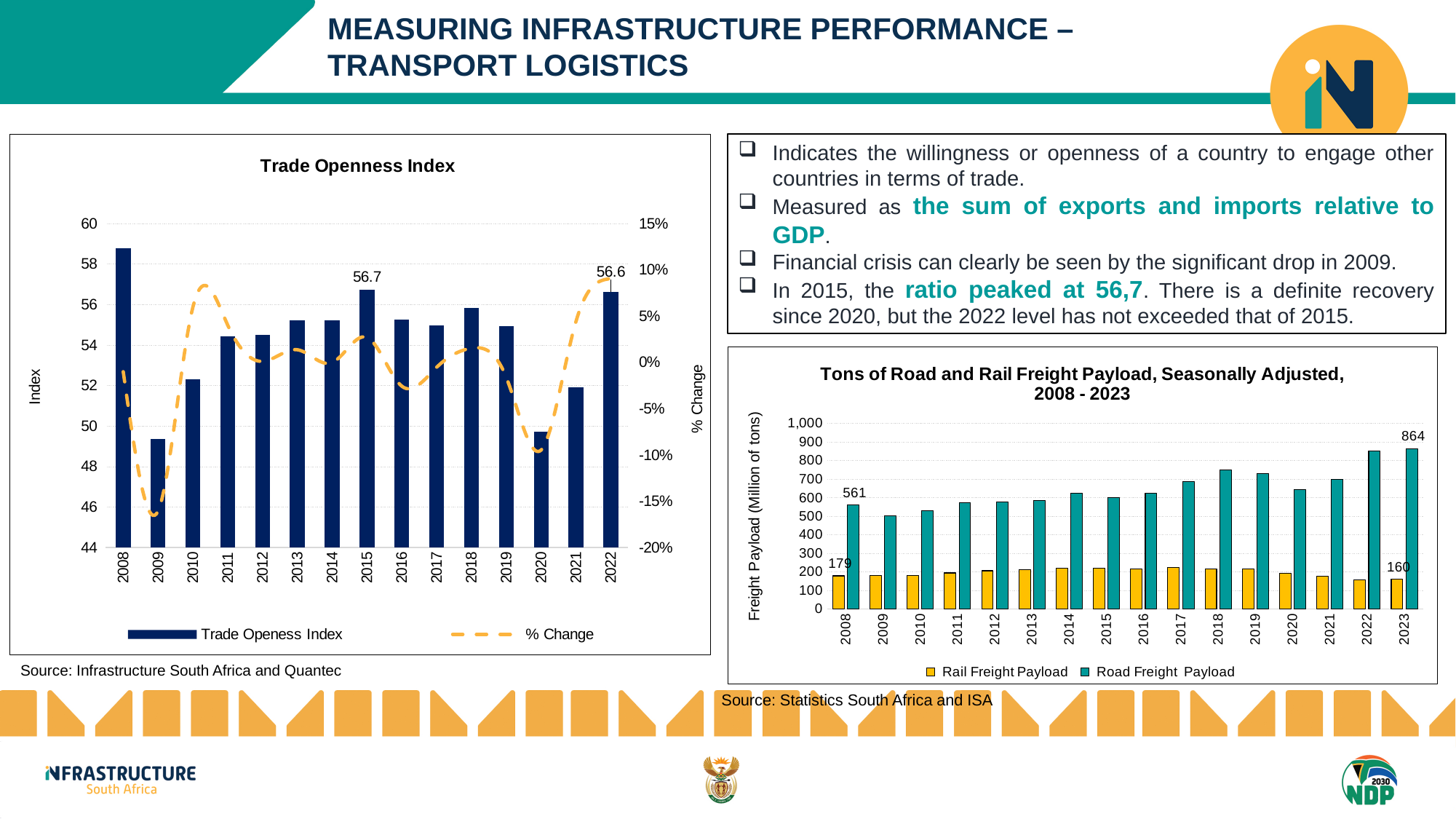
In the Tons of Road and Rail Freight Payload chart, what is the Road Freight Payload for 2023? 864 In the Tons of Road and Rail Freight Payload chart, does the Road Freight Payload generally rise or fall from 2008 to 2023? rise In the Trade Openness Index chart, what is the value of the Trade Openness Index for 2015? 56.7 In the Trade Openness Index chart, how many years are shown on the x axis? 15 In the Tons of Road and Rail Freight Payload chart, which is larger: the Rail Freight Payload in 2008 or in 2023? 2008 In the Tons of Road and Rail Freight Payload chart, what is the difference between the Road Freight Payload in 2023 and in 2008? 303 In the Trade Openness Index chart, is the Trade Openness Index for 2018 greater or less than 54? greater In the Trade Openness Index chart, what is the difference between the 2015 and 2022 Trade Openness Index values? 0.1 In the Trade Openness Index chart, what is the value of the Trade Openness Index for 2022? 56.6 In the Tons of Road and Rail Freight Payload chart, how many series does the legend list? 2 In the Tons of Road and Rail Freight Payload chart, what is the Rail Freight Payload for 2008? 179 In the Trade Openness Index chart, which year has the highest Trade Openness Index bar? 2008